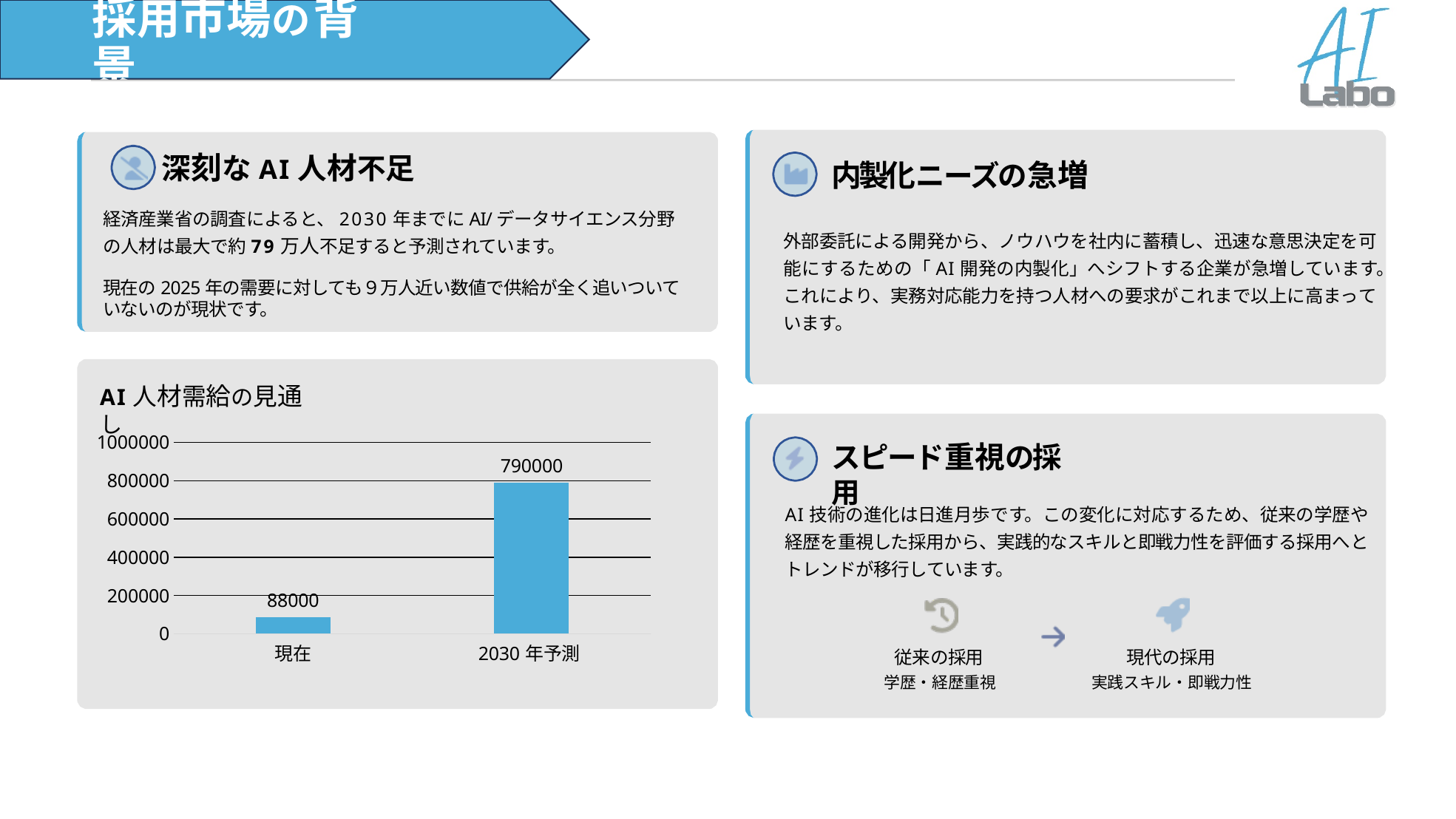
Do the values rise or fall from 現在 to 2030 年予測 in the AI 人材需給の見通し chart? rise What kind of chart is the AI 人材需給の見通し chart? bar chart Which is larger in the AI 人材需給の見通し chart, 現在 or 2030 年予測? 2030 年予測 What is the difference between the 2030 年予測 value and the 現在 value in the AI 人材需給の見通し chart? 702000 Which category has the lowest value in the AI 人材需給の見通し chart? 現在 How many categories are shown in the AI 人材需給の見通し chart? 2 What is the value for 現在 in the AI 人材需給の見通し chart? 88000 Is the value for 2030 年予測 greater or less than 600000? greater What is the title of the chart on the slide? AI 人材需給の見通し Which category has the highest value in the AI 人材需給の見通し chart? 2030 年予測 What is the value for 2030 年予測 in the AI 人材需給の見通し chart? 790000 Is the value for 現在 greater or less than 200000? less